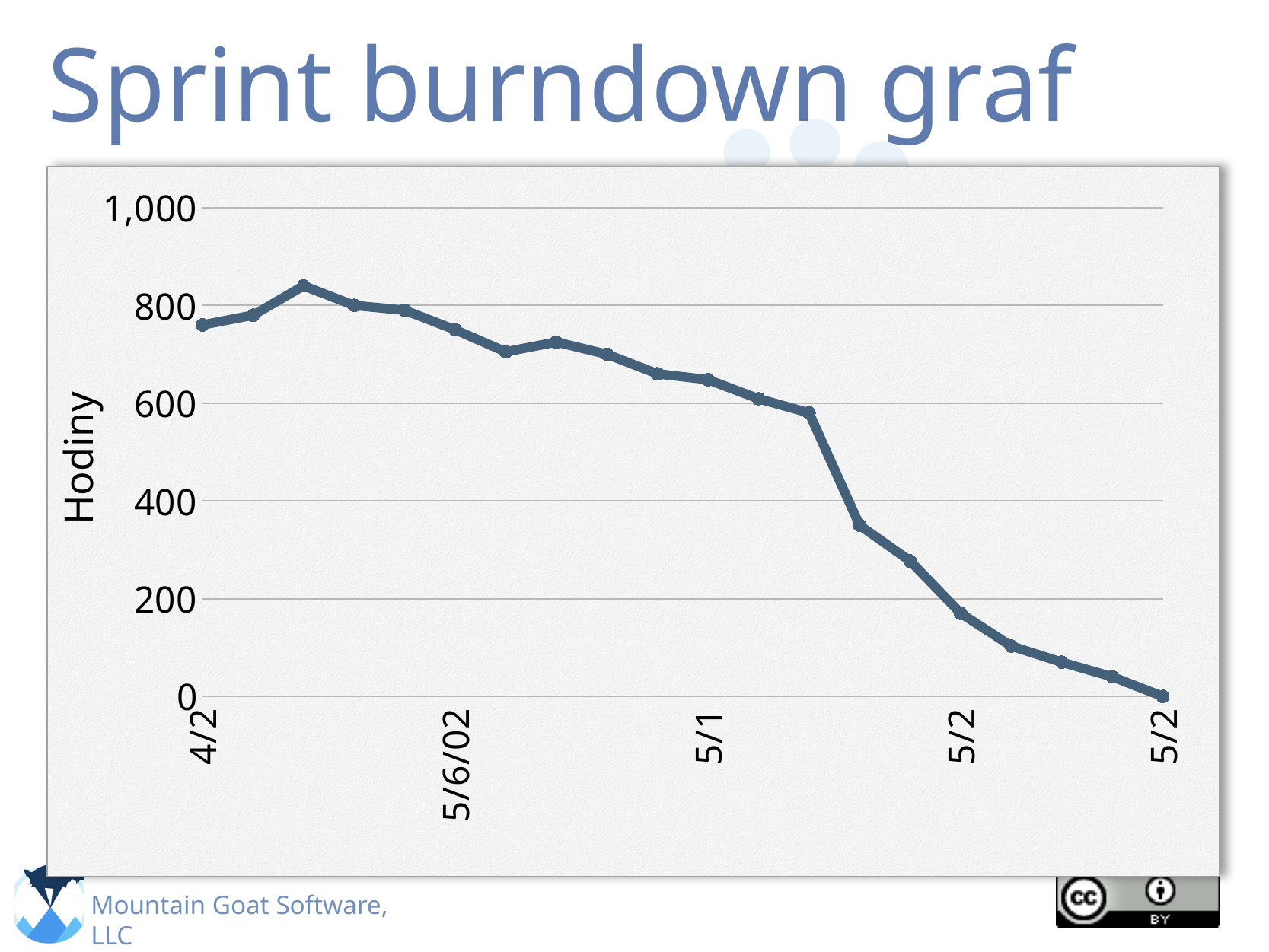
Is the highest value on the line greater or less than 1,000? less What is the title of the slide's chart? Sprint burndown graf What is the label of the vertical axis? Hodiny Which is larger, the value of the first point or the value of the last point? the first point Is the value of the first point on the line greater or less than 600? greater What kind of chart is shown on the slide? line chart Is the value of the first point on the line greater or less than 800? less Overall, do the values rise or fall from left to right along the x axis? fall What is the value of the last point on the line? 0